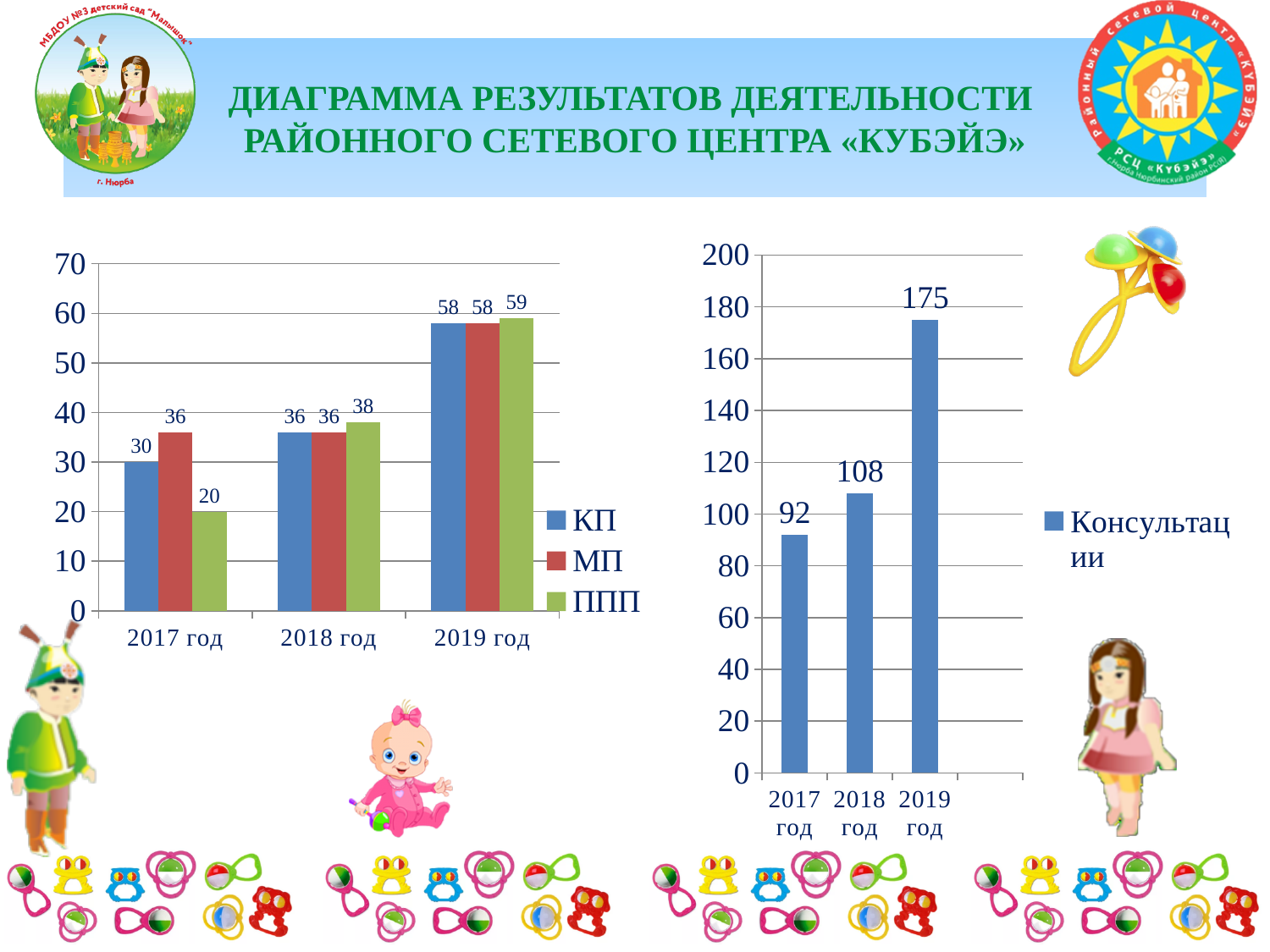
In the left chart, which year has the lowest value for ППП? 2017 год In the left chart, how many series does the legend list? 3 What kind of chart is the right chart? bar chart In the left chart, what is the value for КП in 2019 год? 58 In the right chart, how many categories are shown on the x axis? 3 In the left chart, what is the value for ППП in 2017 год? 20 In the left chart, what is the difference between the ППП values for 2019 год and 2017 год? 39 In the right chart, what is the difference between the values for 2019 год and 2017 год? 83 In the left chart, what is the value for МП in 2018 год? 36 In the left chart, do the КП values rise or fall from 2017 год to 2019 год? rise In the right chart, what is the value for Консультации in 2018 год? 108 In the right chart, which year has the highest value? 2019 год